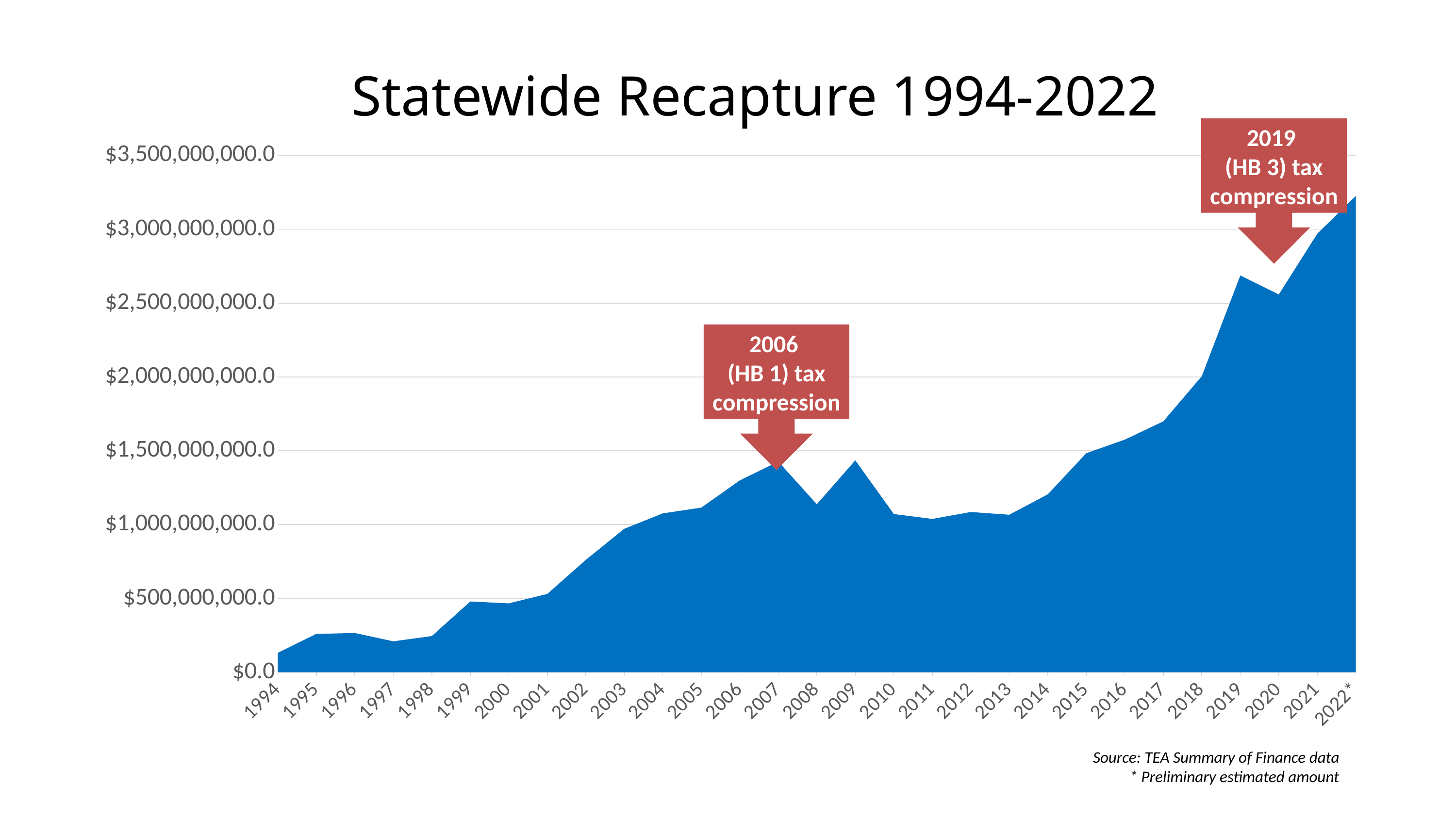
Overall, do the values rise or fall from 1994 to 2022? Rise Which year has the lowest statewide recapture value? 1994 Which year has the larger value, 2007 or 2008? 2007 Which year has the larger value, 2019 or 2020? 2019 How many years are plotted along the x axis? 29 Is the value for 2018 greater or less than $1,500,000,000.0? greater Which year has the highest statewide recapture value? 2022* What type of chart is shown on the slide? Area chart Is the value for 2010 greater or less than $1,500,000,000.0? less Is the value for 1994 greater or less than $500,000,000.0? less What is the title of the chart? Statewide Recapture 1994-2022